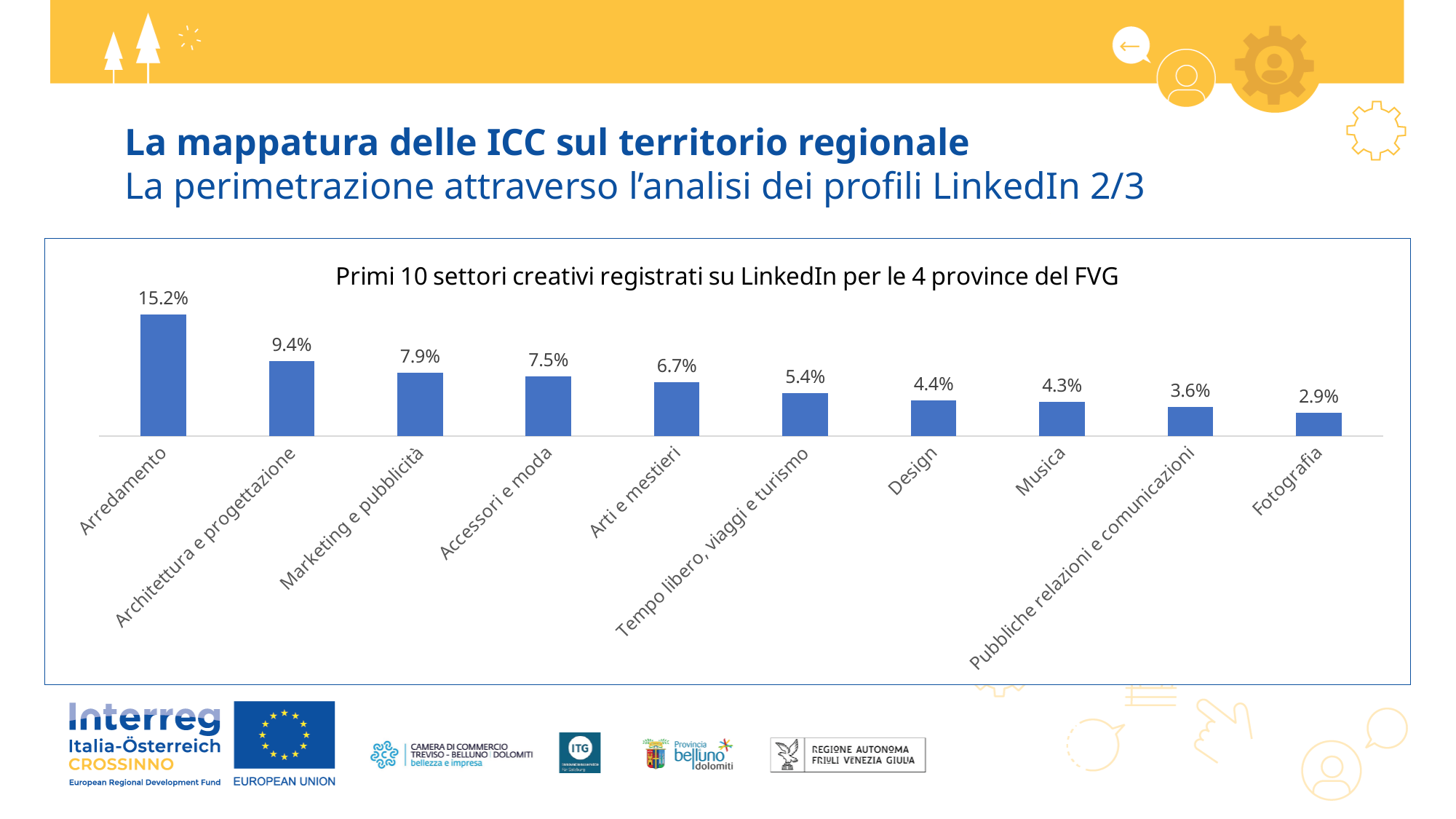
What is the difference between Arredamento and Architettura e progettazione? 5.8% What is the value for Arredamento? 15.2% Which is larger, Accessori e moda or Arti e mestieri? Accessori e moda How many sectors are shown in the chart? 10 Which sector has the lowest value? Fotografia What kind of chart is shown? Bar chart What is the value for Fotografia? 2.9% Which sector has the highest value? Arredamento What is the value for Marketing e pubblicità? 7.9% What is the value for Design? 4.4% What is the title of the chart? Primi 10 settori creativi registrati su LinkedIn per le 4 province del FVG Do the values rise or fall from left to right along the x axis? Fall